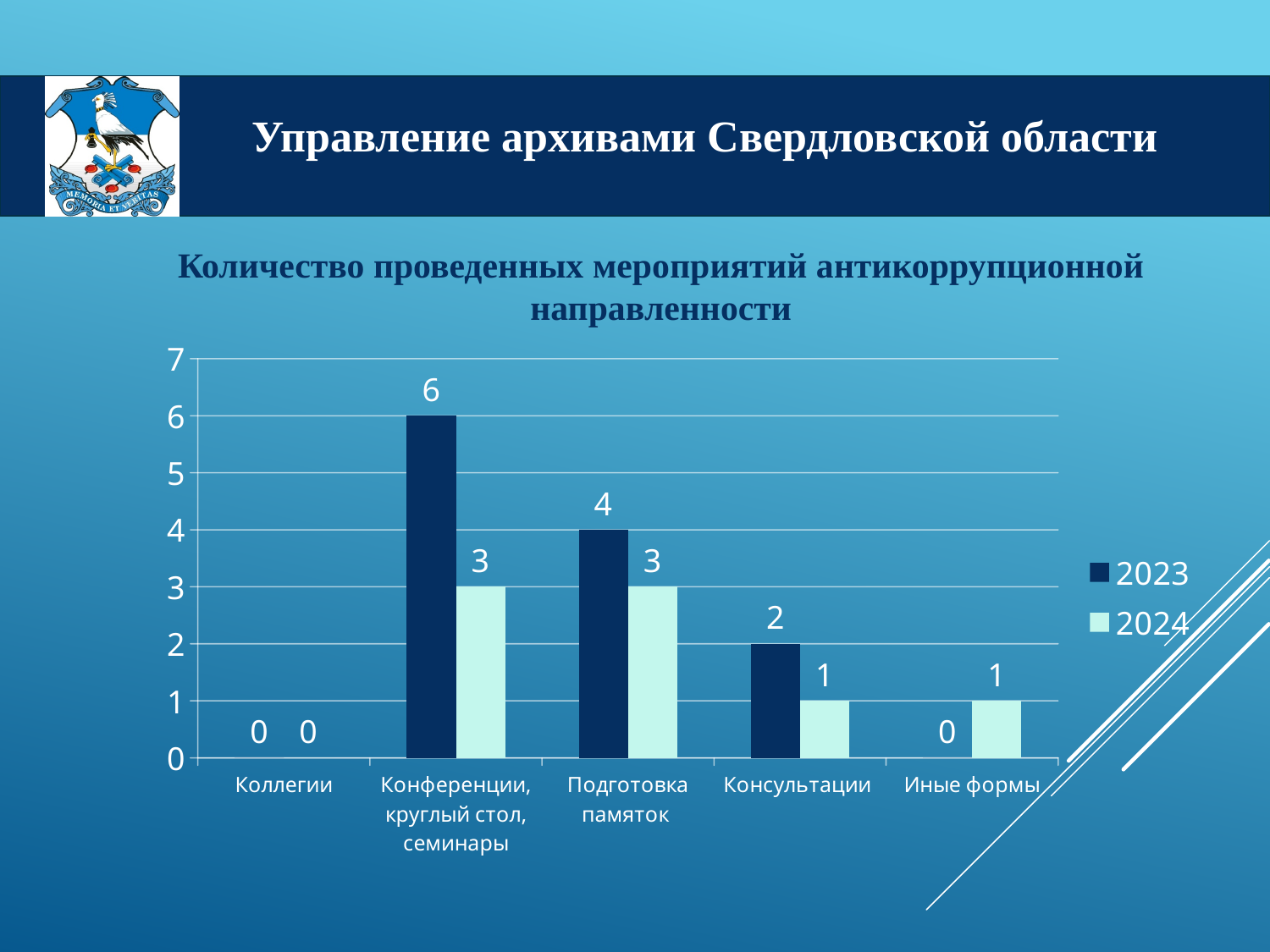
What is the value for 2024 in the category 'Иные формы'? 1 What is the value for 2024 in the category 'Подготовка памяток'? 3 What is the difference between the 2023 values for 'Подготовка памяток' and 'Консультации'? 2 What is the difference between the 2023 and 2024 values for 'Конференции, круглый стол, семинары'? 3 Which is larger for 'Подготовка памяток': the 2023 value or the 2024 value? 2023 What is the title of the chart? Количество проведенных мероприятий антикоррупционной направленности What is the value for 2023 in the category 'Консультации'? 2 How many categories are shown on the x axis? 5 Which category has the highest value for 2023? Конференции, круглый стол, семинары What kind of chart is shown on the slide? Bar chart What is the value for 2023 in the category 'Конференции, круглый стол, семинары'? 6 How many series does the legend list? 2